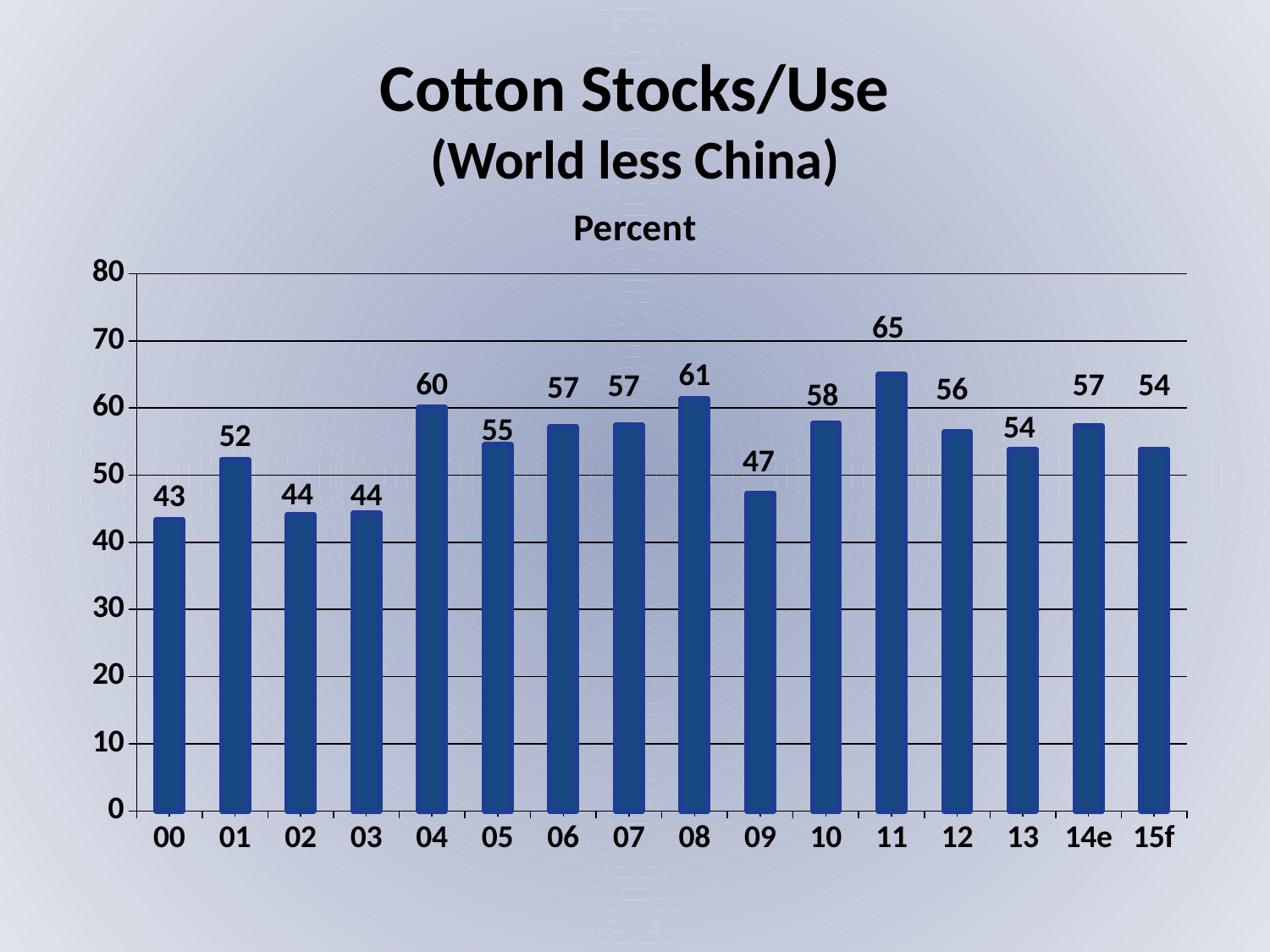
What is the value shown for 09? 47 What is the value shown for 15f? 54 Which is larger, the value for 04 or the value for 05? 04 Is the value for 08 greater or less than 60? greater What is the difference between the values for 11 and 09? 18 Do the values rise or fall from 00 to 04? rise What unit is indicated above the chart? Percent Which year has the lowest stocks/use value? 00 How many bars are plotted in the chart? 16 Which year has the highest stocks/use value? 11 What kind of chart is shown on the slide? bar chart What is the cotton stocks/use value for 11? 65